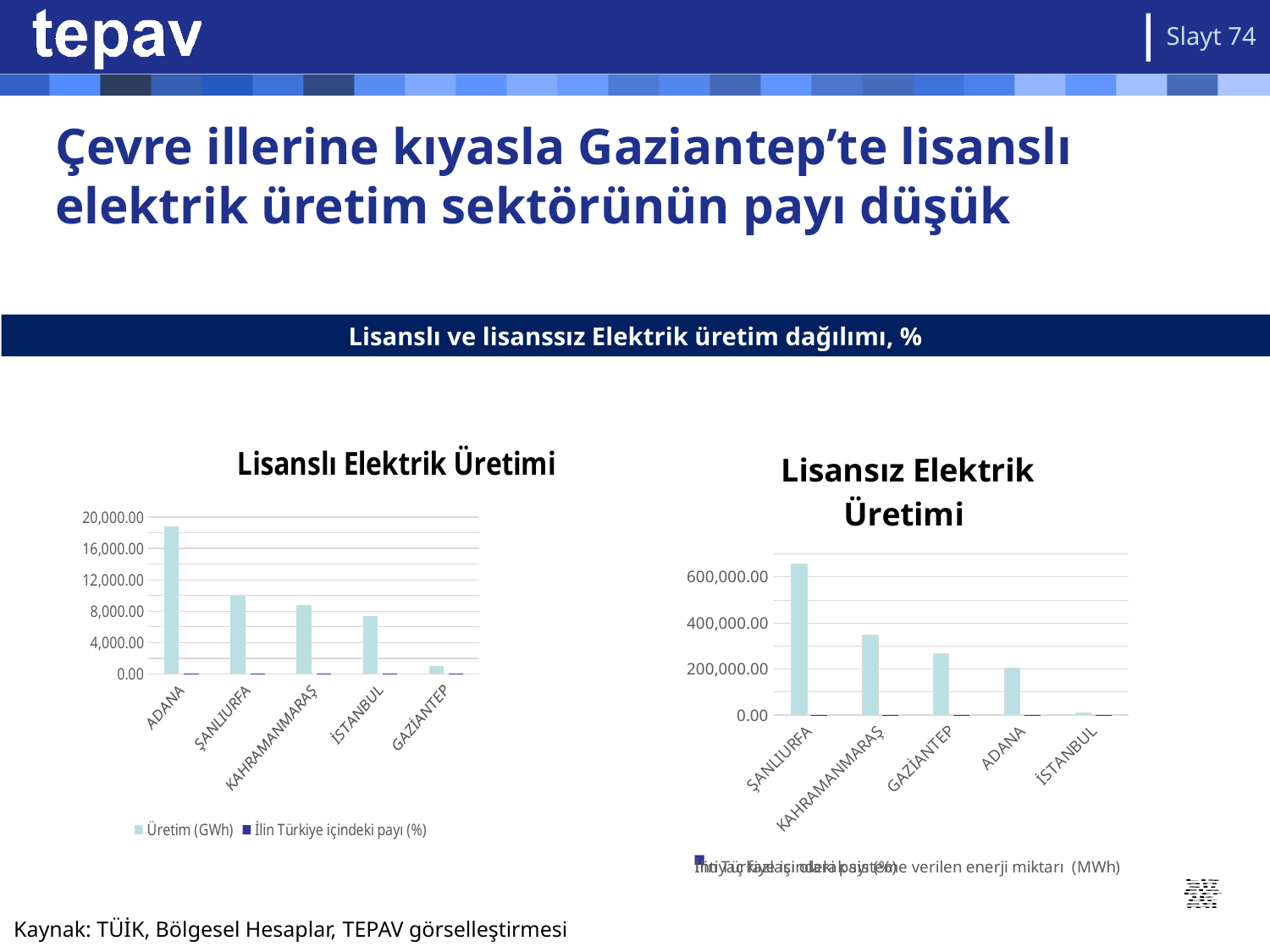
In the 'Lisanslı Elektrik Üretimi' chart on the left, do the Üretim (GWh) bars rise or fall from left to right? fall In the 'Lisanslı Elektrik Üretimi' chart on the left, is the Üretim (GWh) value for ADANA greater or less than 16,000.00? greater In the 'Lisanslı Elektrik Üretimi' chart on the left, is the Üretim (GWh) value for GAZİANTEP greater or less than 4,000.00? less In the 'Lisanslı Elektrik Üretimi' chart on the left, which province has the lowest Üretim (GWh) value? GAZİANTEP In the 'Lisansız Elektrik Üretimi' chart on the right, is the value for ŞANLIURFA greater or less than 600,000.00? greater In the 'Lisanslı Elektrik Üretimi' chart on the left, which province has the highest Üretim (GWh) value? ADANA In the 'Lisansız Elektrik Üretimi' chart on the right, which province has the lowest value? İSTANBUL In the 'Lisansız Elektrik Üretimi' chart on the right, which province has the highest value? ŞANLIURFA In the 'Lisansız Elektrik Üretimi' chart on the right, which is larger, the value for KAHRAMANMARAŞ or the value for GAZİANTEP? KAHRAMANMARAŞ In the 'Lisanslı Elektrik Üretimi' chart on the left, what kind of chart is shown? bar chart In the 'Lisanslı Elektrik Üretimi' chart on the left, how many series does the legend list? 2 In the 'Lisanslı Elektrik Üretimi' chart on the left, how many provinces are shown on the x axis? 5